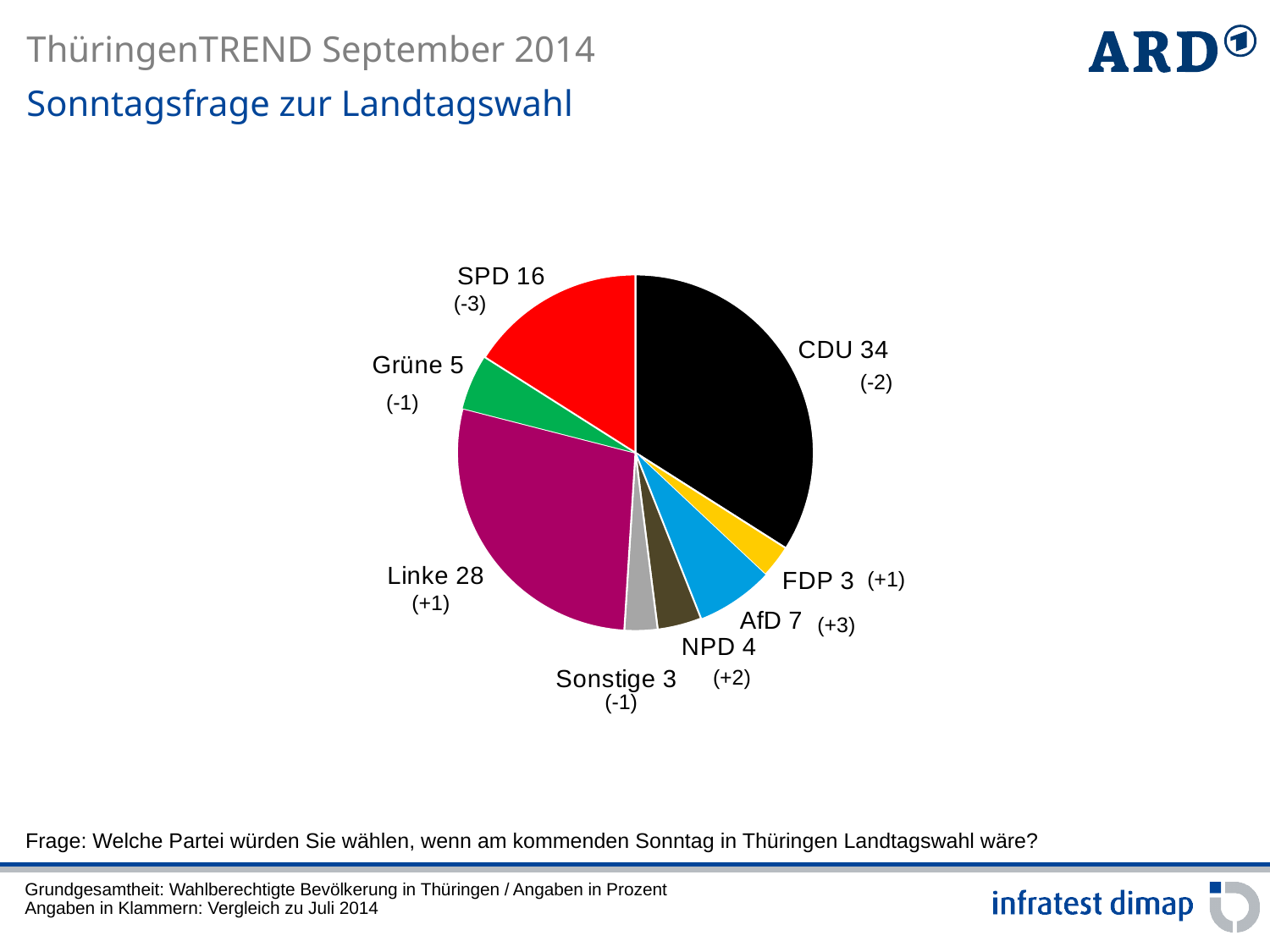
What is the value shown for Linke? 28 How many slices does the pie chart have? 8 Which is larger, the value for Linke or the value for SPD? Linke Which party has the largest slice of the pie? CDU What change compared to July 2014 is shown in parentheses for SPD? -3 What is the title of the slide above the chart? Sonntagsfrage zur Landtagswahl What is the difference between the values for CDU and Linke? 6 What is the value shown for AfD? 7 What is the value shown for CDU? 34 What kind of chart is shown on the slide? pie chart What change compared to July 2014 is shown in parentheses for AfD? +3 What is the value shown for SPD? 16